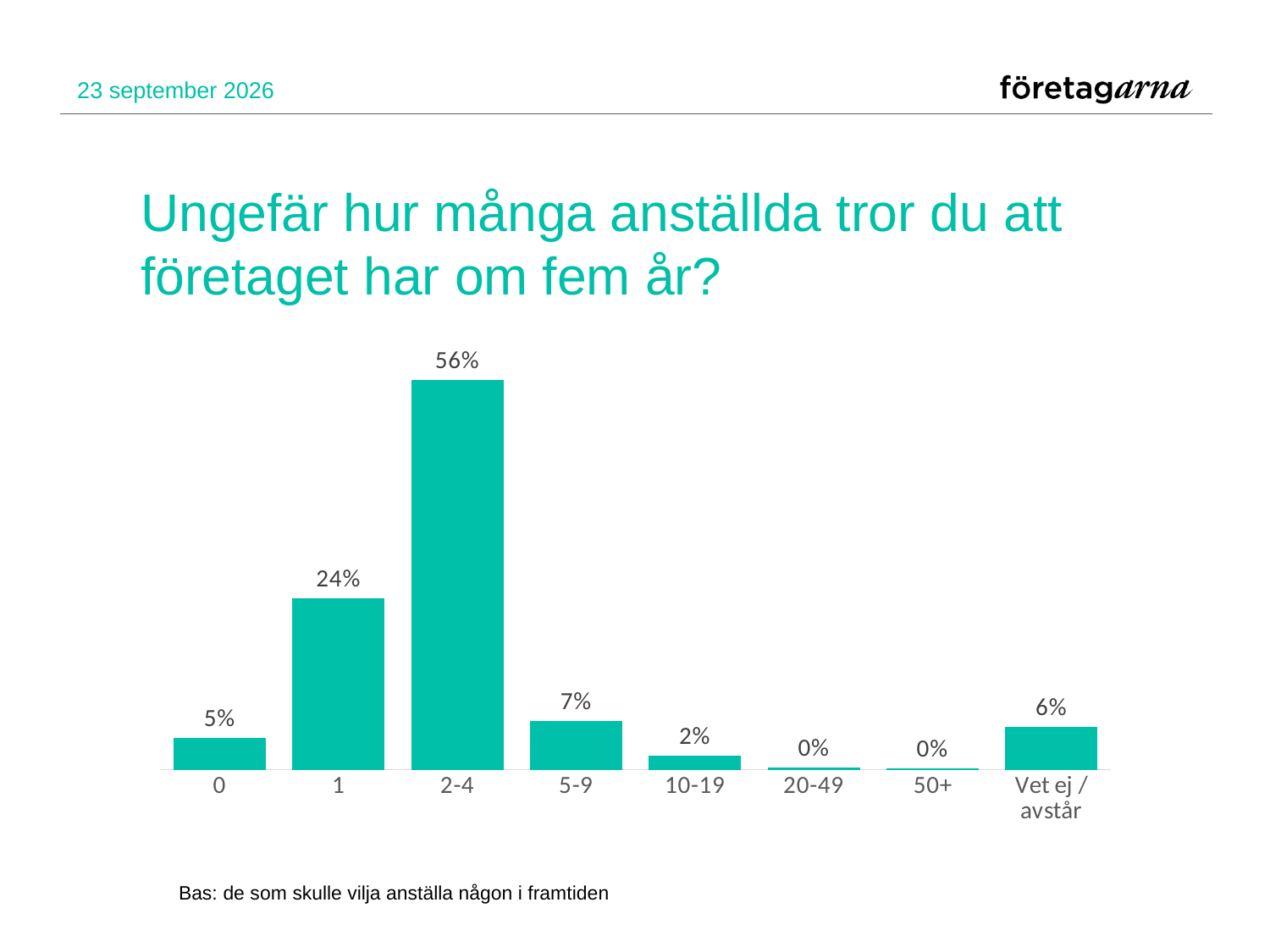
What is the difference between the values for "5-9" and "0"? 2% How many categories are shown on the x axis? 8 What is the value for the category "Vet ej / avstår"? 6% What is the difference between the values for "2-4" and "1"? 32% Which is larger, the value for "0" or the value for "Vet ej / avstår"? Vet ej / avstår Which categories have a value of 0%? 20-49 and 50+ What is the value for the category "1"? 24% What kind of chart is shown on the slide? Bar chart Which category has the highest value? 2-4 What is the value for the category "2-4"? 56% What is the value for the category "10-19"? 2% What is the base (Bas) stated below the chart? de som skulle vilja anställa någon i framtiden